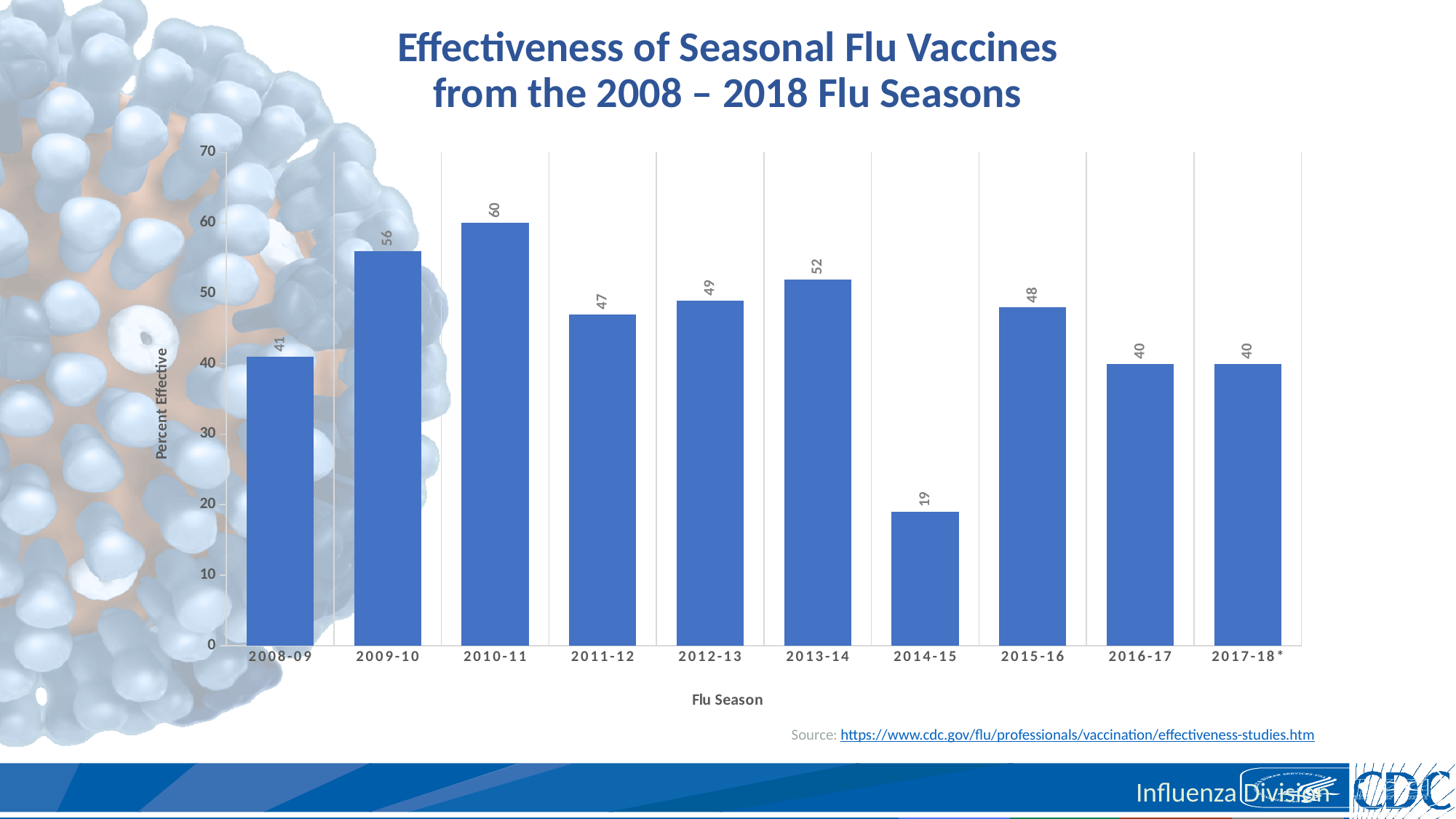
What is the difference in percent effective between the 2010-11 and 2014-15 seasons? 41 How many flu seasons are shown on the x axis? 10 What is the title of the chart? Effectiveness of Seasonal Flu Vaccines from the 2008 – 2018 Flu Seasons Which flu season has the highest vaccine effectiveness? 2010-11 What is the percent effective value for the 2010-11 flu season? 60 What is the percent effective value for the 2014-15 flu season? 19 What kind of chart is shown on the slide? bar chart Is the value for the 2008-09 season greater or less than 50? less What is the label of the y axis? Percent Effective Which flu season has the lowest vaccine effectiveness? 2014-15 Which season had a higher vaccine effectiveness, 2009-10 or 2012-13? 2009-10 What is the percent effective value for the 2013-14 flu season? 52